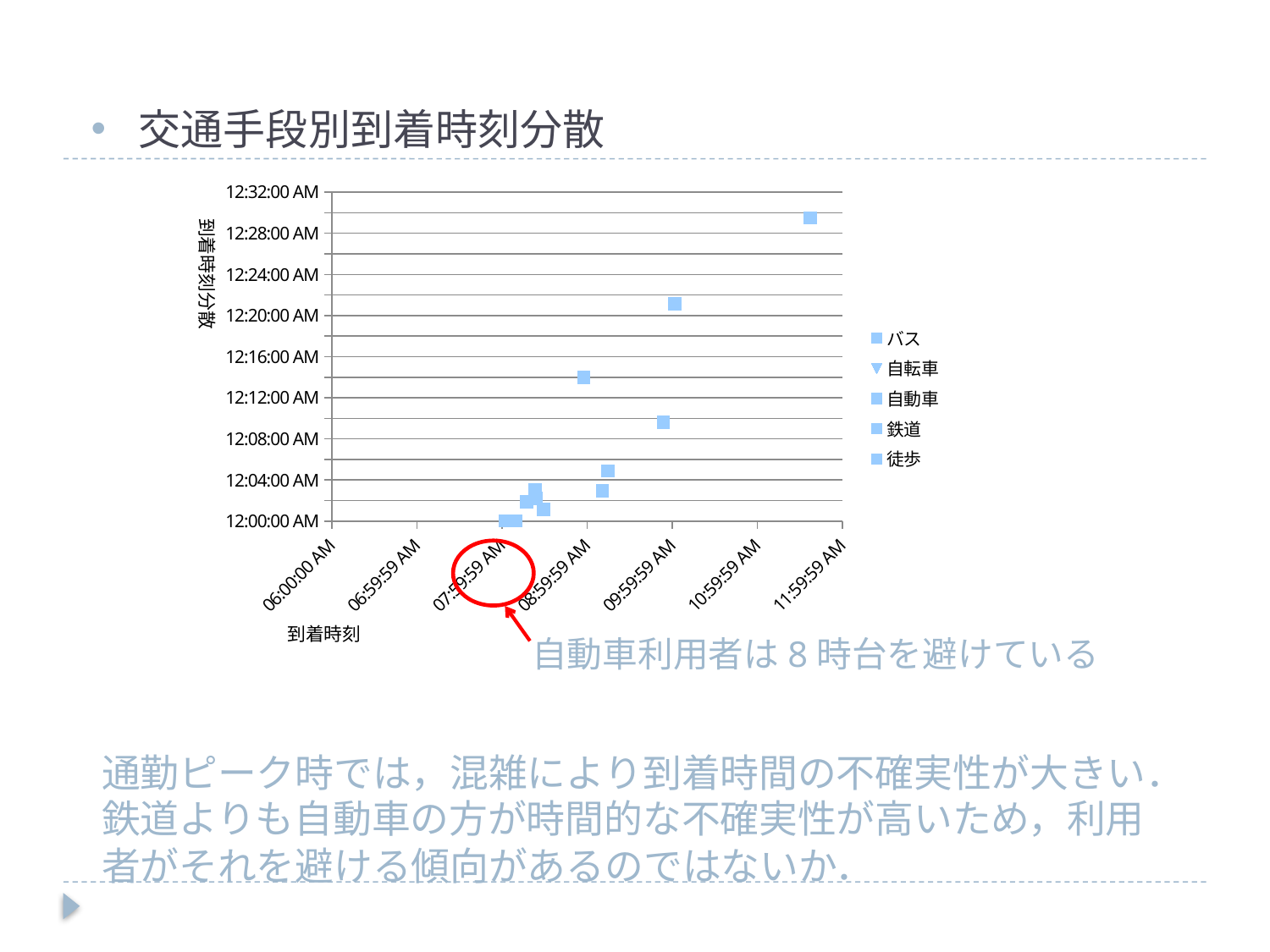
Do the plotted values generally rise or fall as arrival time increases along the x axis? rise How many series does the chart legend list? 5 How many tick labels are shown on the x axis of the chart? 7 Is the point with the largest y value located before or after 10:59:59 AM on the x axis? after What is the label of the x axis of the chart? 到着時刻 Is the highest plotted point on the chart greater or less than 12:28:00 AM on the y axis? greater Are the points plotted near 07:59:59 AM on the x axis greater or less than 12:04:00 AM on the y axis? less What is the title of the chart on the slide? 交通手段別到着時刻分散 What kind of chart is shown on the slide? scatter chart How many tick labels are shown on the y axis of the chart? 9